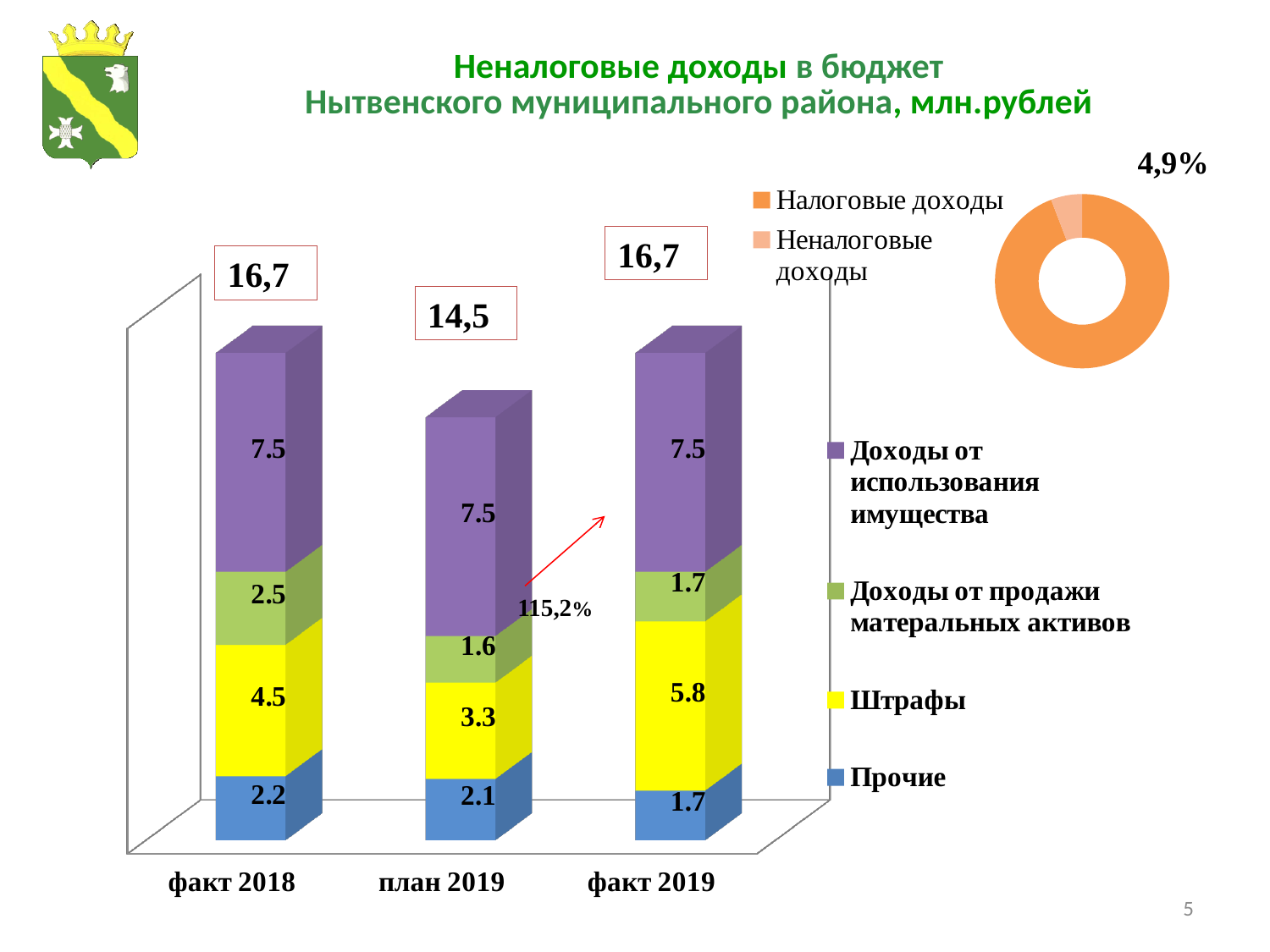
In the stacked bar chart, which is larger: Прочие for факт 2018 or Прочие for факт 2019? факт 2018 In the donut chart at the top right, what share is shown for Неналоговые доходы? 4,9% In the donut chart at the top right, which slice is larger: Налоговые доходы or Неналоговые доходы? Налоговые доходы How many series does the legend of the stacked bar chart list? 4 In the stacked bar chart, which category has the lowest total? план 2019 What kind of chart is the chart with the categories факт 2018, план 2019 and факт 2019? stacked bar chart In the stacked bar chart, what is the value of Прочие for план 2019? 2.1 How many categories are shown on the x axis of the stacked bar chart? 3 In the stacked bar chart, what is the total shown above the план 2019 bar? 14,5 In the stacked bar chart, what is the value of Штрафы for факт 2019? 5.8 In the stacked bar chart, what is the difference between Штрафы for факт 2019 and Штрафы for план 2019? 2.5 In the stacked bar chart, what is the value of Доходы от продажи матеральных активов for факт 2018? 2.5